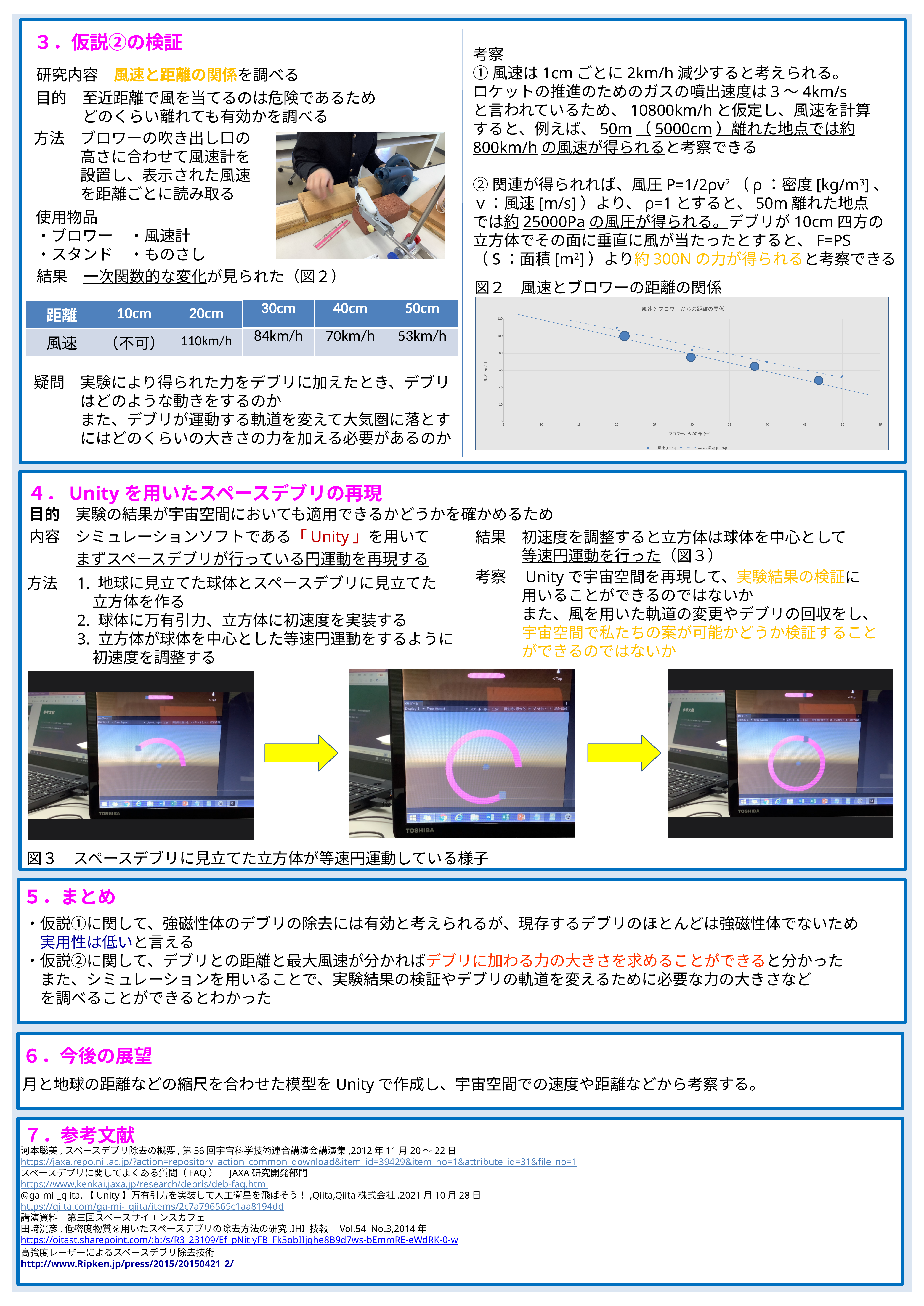
What is the title of the chart in Figure 2? 風速とブロワーからの距離の関係 In the chart 風速とブロワーからの距離の関係, is the wind speed at 30 cm greater or less than 60? greater In the chart 風速とブロワーからの距離の関係, does the wind speed rise or fall as the distance from the blower increases? fall What kind of chart is Figure 2 (風速とブロワーからの距離の関係)? scatter chart In the chart 風速とブロワーからの距離の関係, is the wind speed at 40 cm greater or less than 100? less In the chart 風速とブロワーからの距離の関係, at which distance is the wind speed highest? 20 cm In the chart 風速とブロワーからの距離の関係, is the wind speed at 20 cm larger or smaller than at 40 cm? larger What is the x-axis label of the chart 風速とブロワーからの距離の関係? ブロワーからの距離 [cm] In the chart 風速とブロワーからの距離の関係, is the wind speed at 50 cm greater or less than 80? less How many entries does the legend of the chart 風速とブロワーからの距離の関係 list? 2 In the chart 風速とブロワーからの距離の関係, at which distance is the wind speed lowest? 50 cm